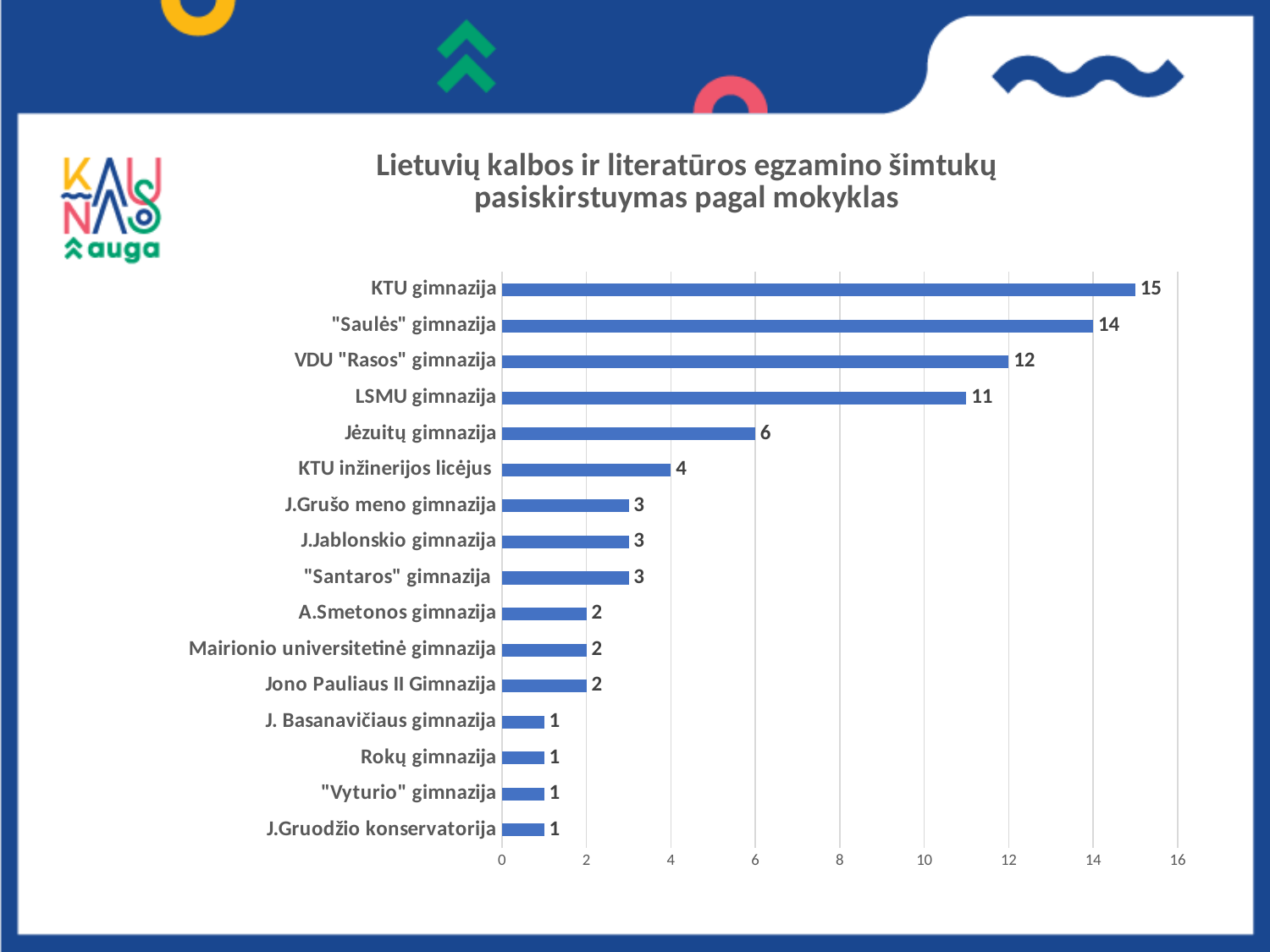
What is the value for LSMU gimnazija? 11 Is the value for "Saulės" gimnazija greater or less than 10? greater What is the value for KTU inžinerijos licėjus? 4 What is the title of the chart? Lietuvių kalbos ir literatūros egzamino šimtukų pasiskirstuymas pagal mokyklas Which school has the highest value? KTU gimnazija How many schools are shown in the chart? 16 What is the difference between the values for VDU "Rasos" gimnazija and Jėzuitų gimnazija? 6 What is the value for Jėzuitų gimnazija? 6 What kind of chart is shown on the slide? bar chart What is the value for KTU gimnazija? 15 What is the difference between the values for KTU gimnazija and "Saulės" gimnazija? 1 Which is larger, the value for LSMU gimnazija or the value for Jėzuitų gimnazija? LSMU gimnazija